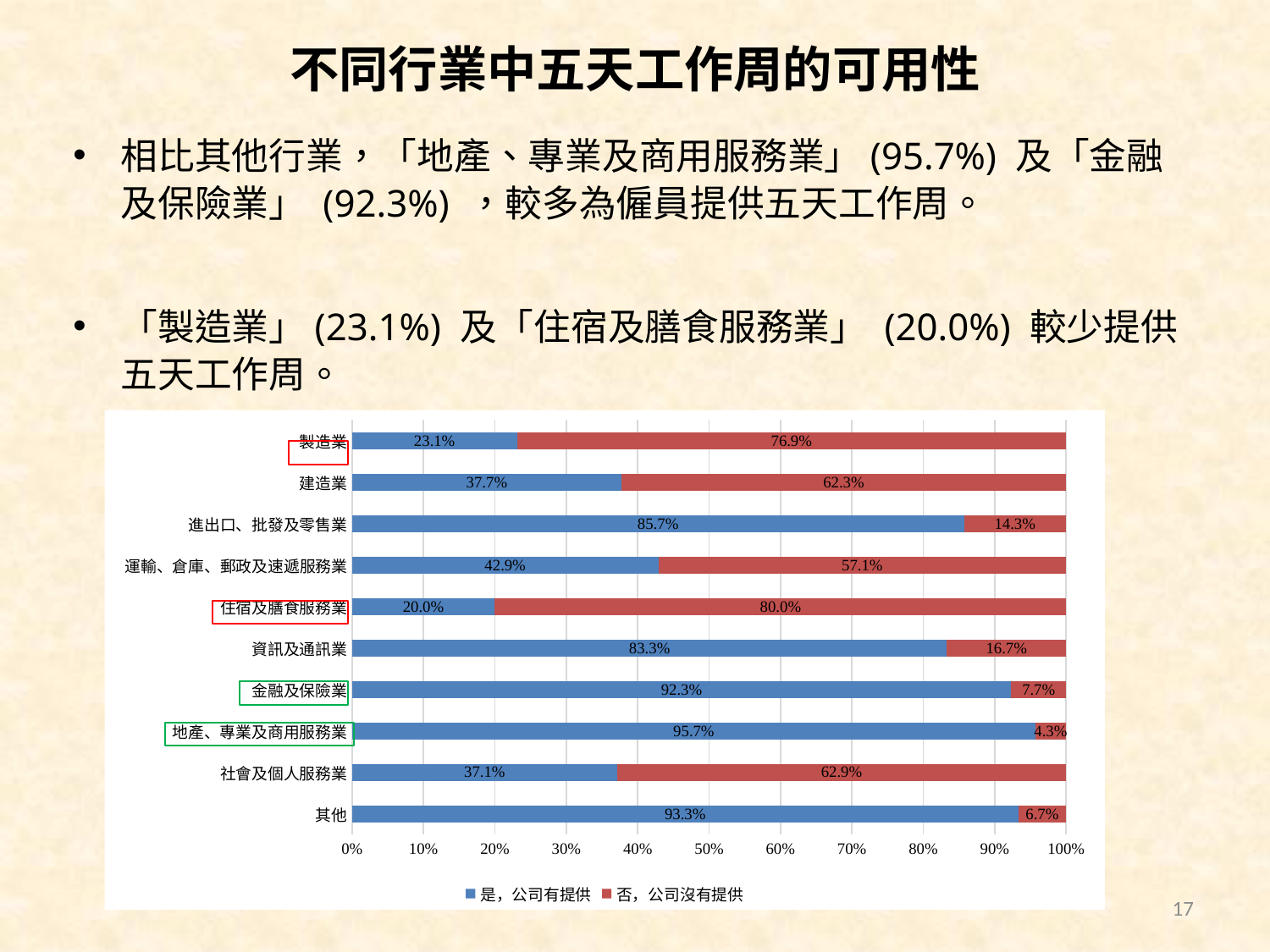
Which industry has the highest value for 是，公司有提供? 地產、專業及商用服務業 Which industry has the lowest value for 是，公司有提供? 住宿及膳食服務業 What is the total of the stacked bar for 社會及個人服務業? 100.0% How many industries are shown on the chart? 10 Which colour represents 否，公司沒有提供 in the chart? Red What is the value of 是，公司有提供 for 運輸、倉庫、郵政及速遞服務業? 42.9% Which has a larger 否，公司沒有提供 value: 資訊及通訊業 or 進出口、批發及零售業? 資訊及通訊業 What is the value of 否，公司沒有提供 for 住宿及膳食服務業? 80.0% How many series does the legend list? 2 What is the difference between the 是，公司有提供 values for 金融及保險業 and 建造業? 54.6% What type of chart is shown on the slide? Stacked bar chart What percentage of companies in 製造業 provide a five-day work week (是，公司有提供)? 23.1%